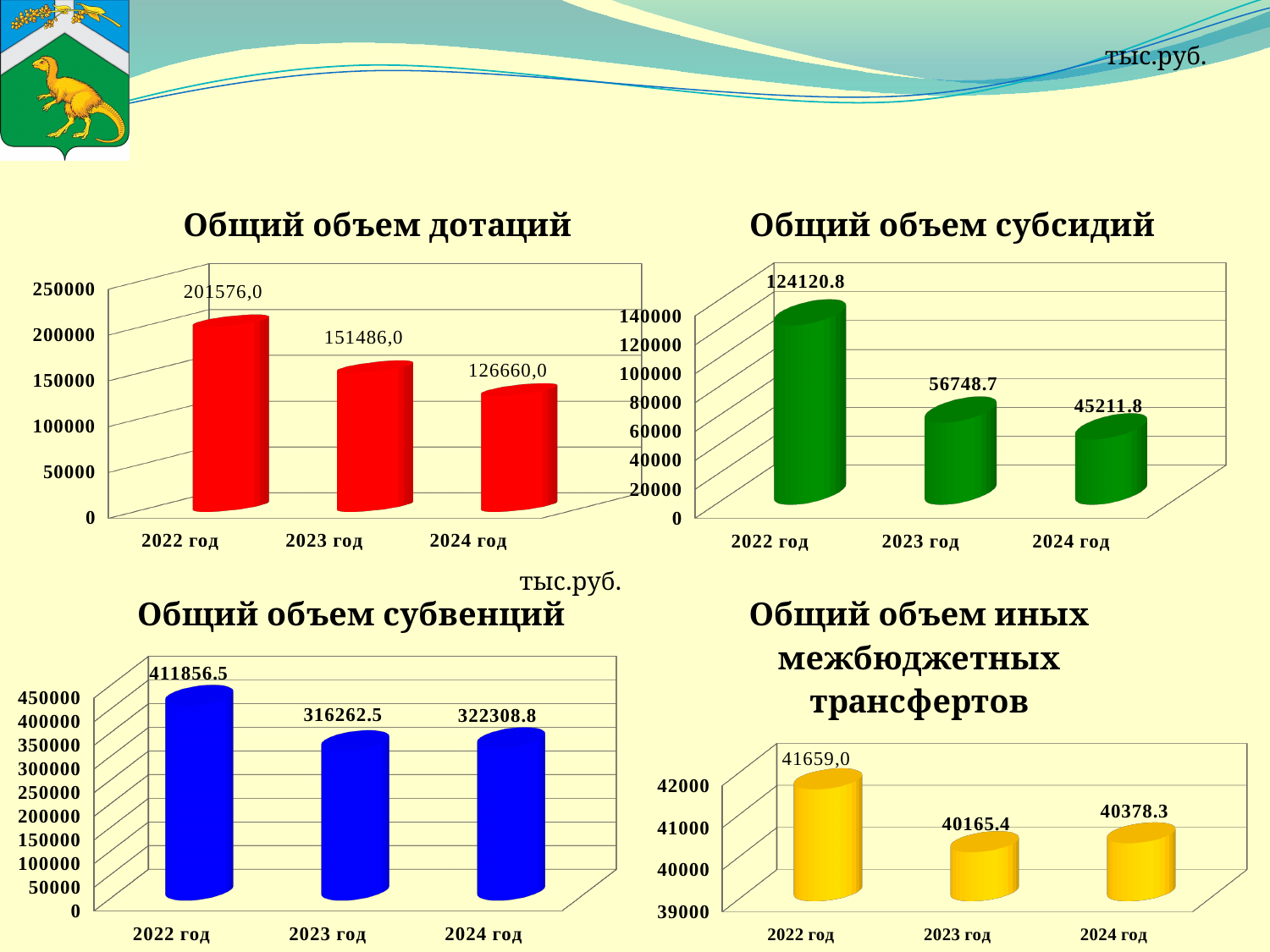
In the chart 'Общий объем иных межбюджетных трансфертов', what is the difference between the values for 2024 год and 2023 год? 212.9 In the chart 'Общий объем субсидий', which year has the highest value? 2022 год In the chart 'Общий объем дотаций', what is the difference between the values for 2022 год and 2023 год? 50090,0 In the chart 'Общий объем субвенций', which is larger, the value for 2023 год or 2024 год? 2024 год In the chart 'Общий объем субсидий', what is the difference between the values for 2022 год and 2024 год? 78909.0 In the chart 'Общий объем дотаций', which year has the lowest value? 2024 год In the chart 'Общий объем иных межбюджетных трансфертов', what is the value for 2023 год? 40165.4 In the chart 'Общий объем субвенций', what is the value for 2024 год? 322308.8 In the chart 'Общий объем дотаций', what is the value for 2022 год? 201576,0 What type of chart is 'Общий объем субвенций'? bar chart In the chart 'Общий объем субсидий', what is the value for 2023 год? 56748.7 How many categories (years) are shown in the chart 'Общий объем дотаций'? 3